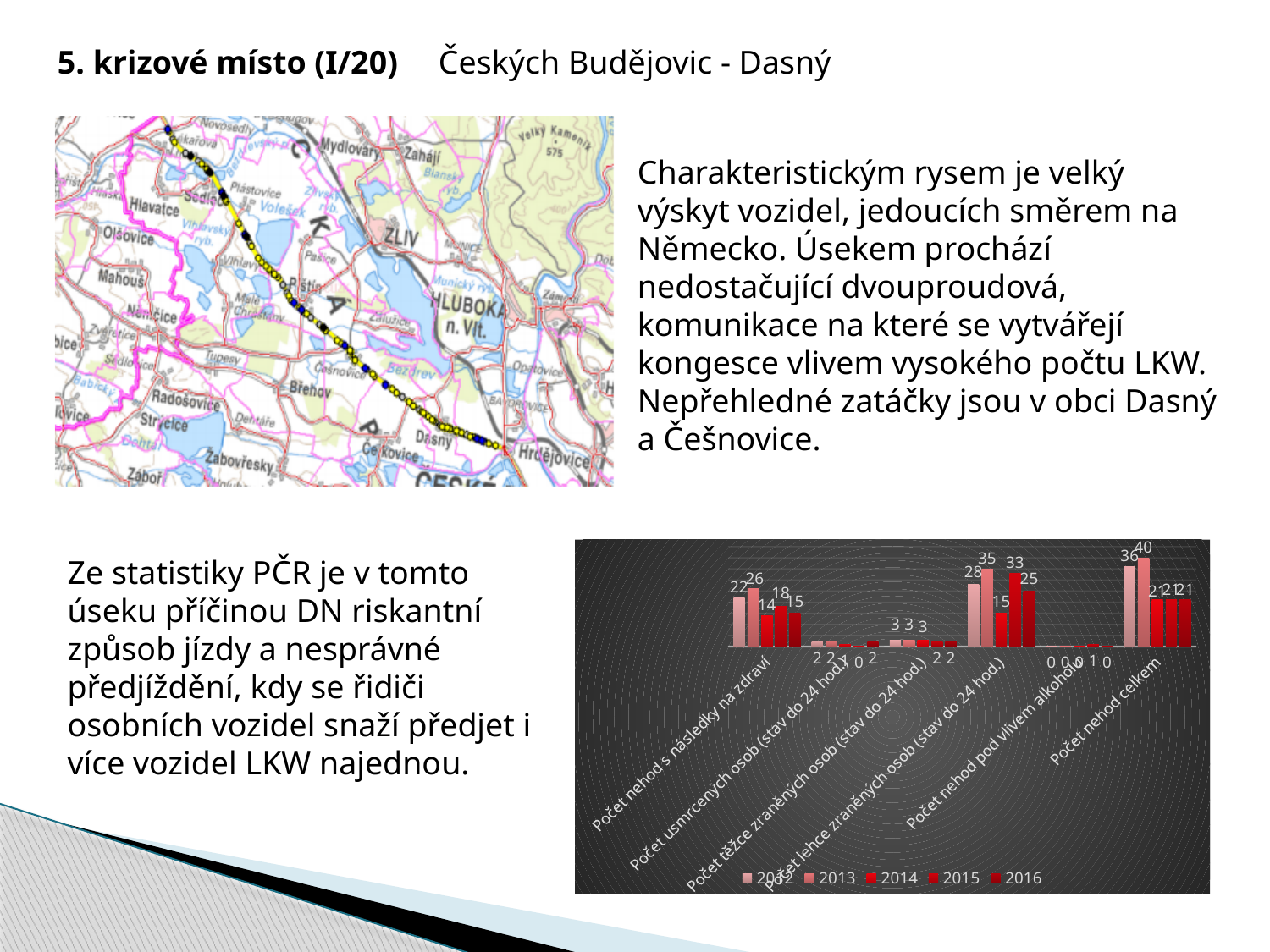
What is the difference between the 2013 and 2014 values in the category "Počet lehce zraněných osob (stav do 24 hod.)"? 20 Which year has the lowest value in the category "Počet nehod s následky na zdraví"? 2014 How many categories are shown on the x axis of the chart? 6 In the category "Počet nehod s následky na zdraví", which is larger: the value for 2012 or for 2013? 2013 What kind of chart is shown on the slide? bar chart How many series does the chart legend list? 5 What is the value for 2013 in the category "Počet nehod celkem"? 40 What is the value for 2015 in the category "Počet nehod pod vlivem alkoholu"? 1 What is the first entry in the chart legend? 2012 Which year has the highest value in the category "Počet nehod celkem"? 2013 What is the difference between the 2013 and 2012 values in the category "Počet nehod celkem"? 4 What is the value for 2012 in the category "Počet lehce zraněných osob (stav do 24 hod.)"? 28